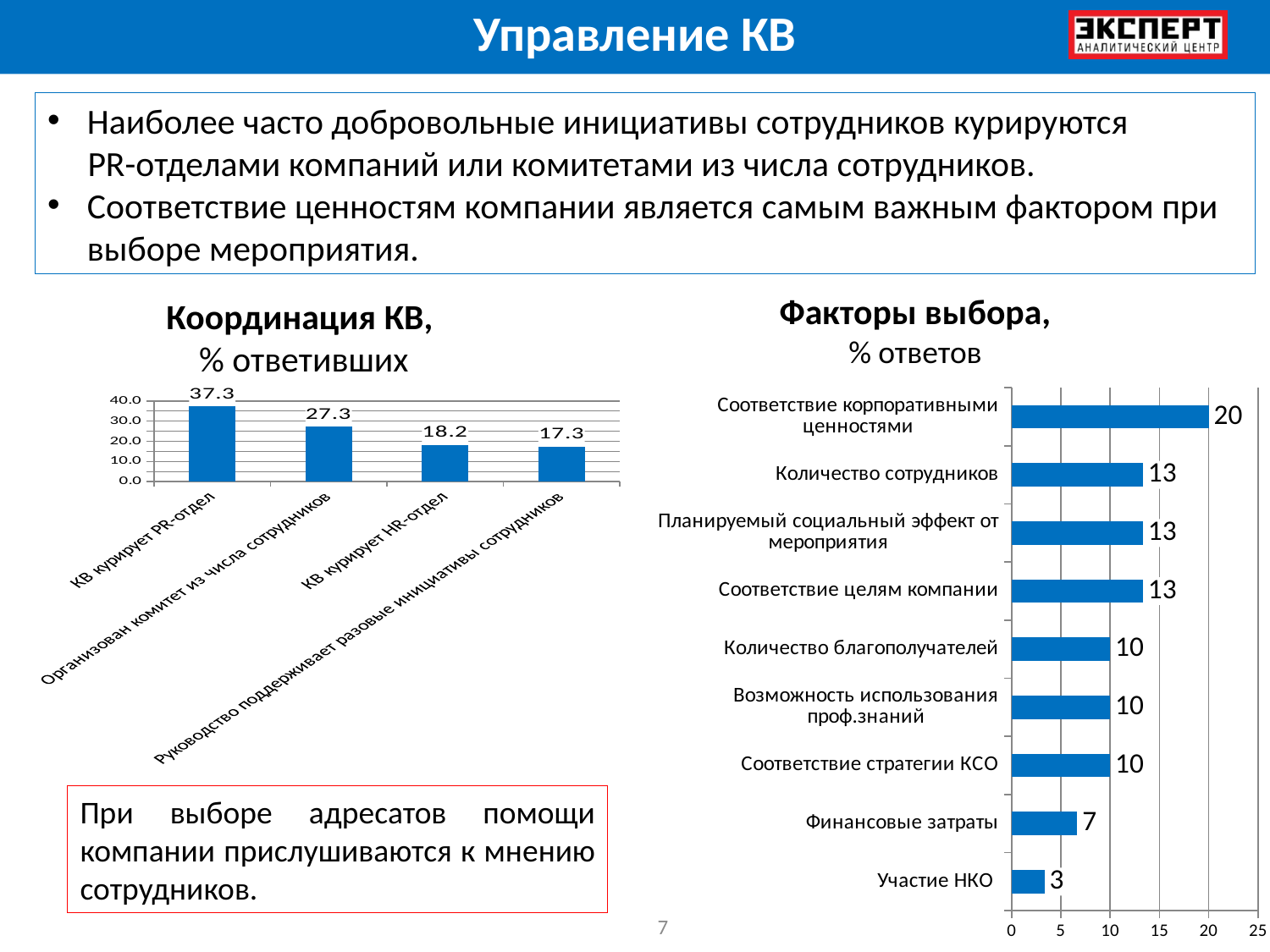
In the chart 'Координация КВ, % ответивших', do the values rise or fall from left to right? fall In the chart 'Факторы выбора, % ответов', which is larger: 'Количество сотрудников' or 'Количество благополучателей'? Количество сотрудников In the chart 'Координация КВ, % ответивших', what is the value for 'КВ курирует HR-отдел'? 18.2 In the chart 'Координация КВ, % ответивших', what is the difference between 'КВ курирует PR-отдел' and 'Организован комитет из числа сотрудников'? 10.0 In the chart 'Факторы выбора, % ответов', which category has the lowest value? Участие НКО In the chart 'Факторы выбора, % ответов', what is the value for 'Соответствие корпоративными ценностями'? 20 What type of chart is 'Факторы выбора, % ответов'? bar chart In the chart 'Координация КВ, % ответивших', what is the value for 'КВ курирует PR-отдел'? 37.3 In the chart 'Факторы выбора, % ответов', what is the value for 'Финансовые затраты'? 7 In the chart 'Факторы выбора, % ответов', how many categories are shown? 9 In the chart 'Координация КВ, % ответивших', which category has the lowest value? Руководство поддерживает разовые инициативы сотрудников In the chart 'Координация КВ, % ответивших', how many categories are shown? 4